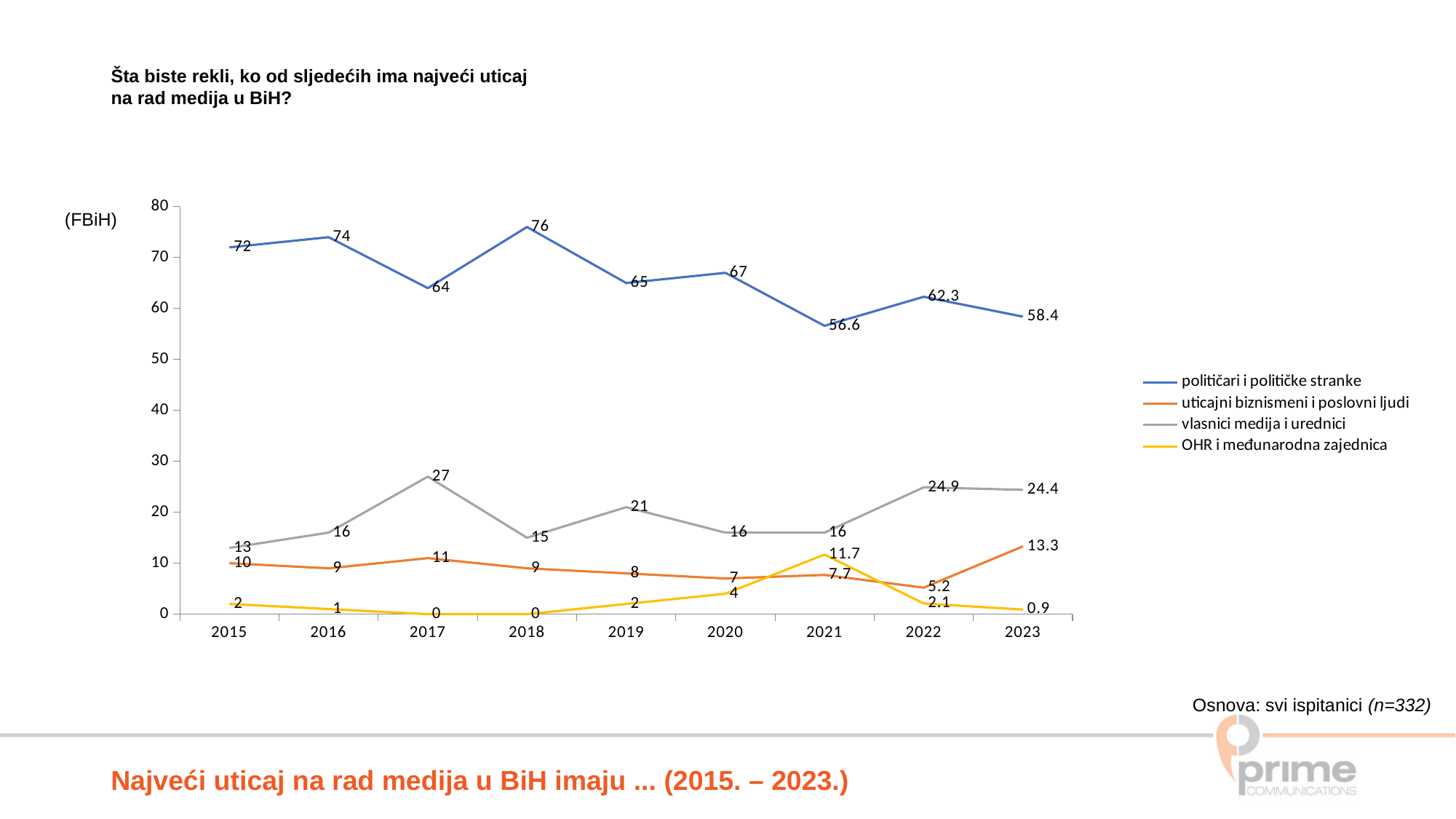
What is the value for 'vlasnici medija i urednici' in 2017? 27 In which year is the value for 'političari i političke stranke' lowest? 2021 Which is larger in 2022: the value for 'vlasnici medija i urednici' or for 'uticajni biznismeni i poslovni ljudi'? vlasnici medija i urednici In which year is the value for 'vlasnici medija i urednici' highest? 2017 What is the value for 'OHR i međunarodna zajednica' in 2021? 11.7 What is the value for 'uticajni biznismeni i poslovni ljudi' in 2023? 13.3 What is the difference between the 'političari i političke stranke' values in 2018 and 2023? 17.6 What is the value for 'političari i političke stranke' in 2018? 76 Which series is drawn in yellow in the legend? OHR i međunarodna zajednica How many years are shown on the x axis? 9 How many series does the legend list? 4 What kind of chart is shown on the slide? line chart